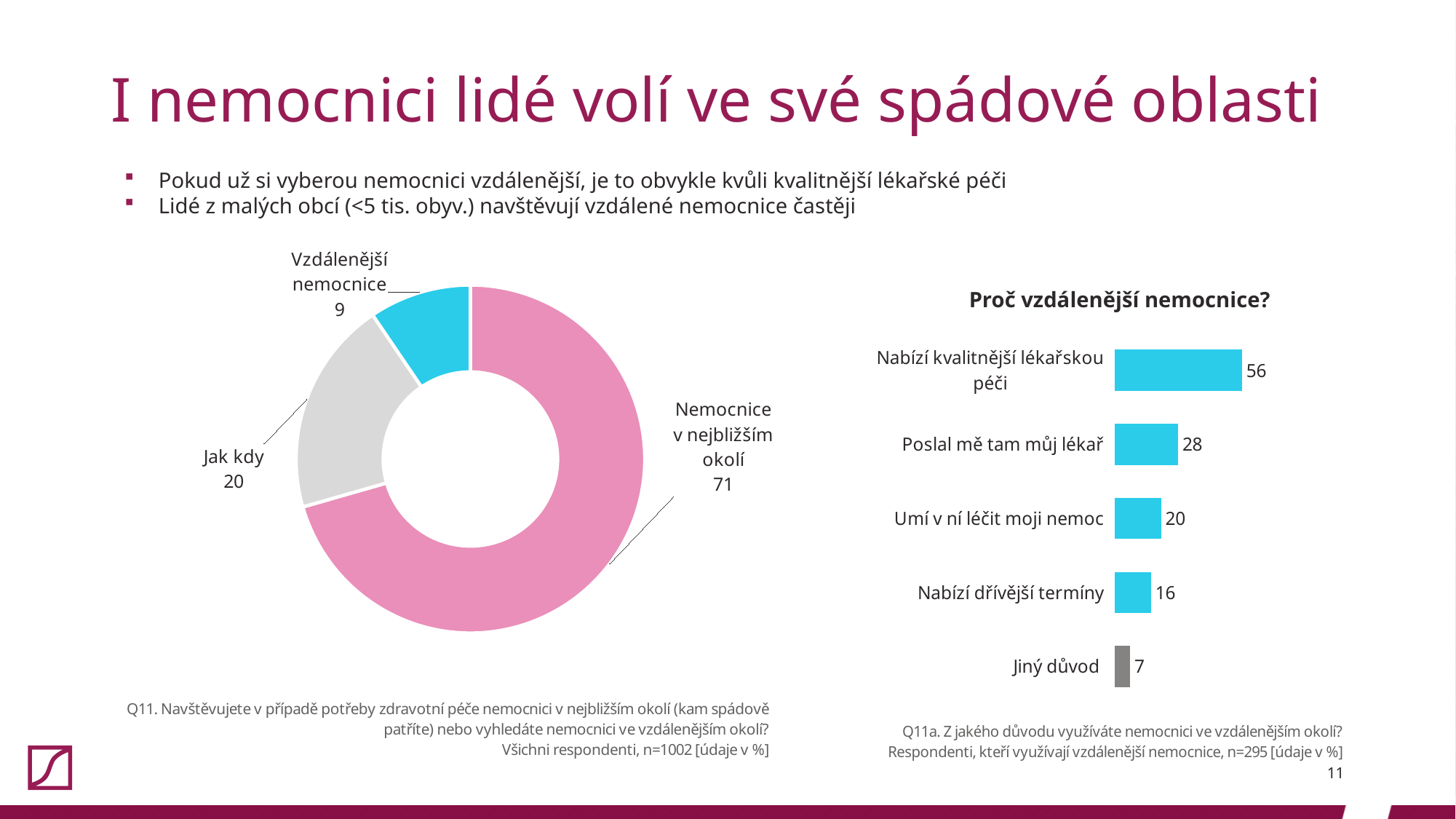
In the chart "Proč vzdálenější nemocnice?", which category has the lowest value? Jiný důvod In the chart "Proč vzdálenější nemocnice?", what is the difference between "Nabízí kvalitnější lékařskou péči" and "Nabízí dřívější termíny"? 40 In the donut chart on the left, what is the value for "Jak kdy"? 20 In the chart "Proč vzdálenější nemocnice?", what is the value for "Poslal mě tam můj lékař"? 28 In the chart "Proč vzdálenější nemocnice?", which category has the highest value? Nabízí kvalitnější lékařskou péči In the donut chart on the left, what is the difference between "Nemocnice v nejbližším okolí" and "Jak kdy"? 51 In the chart "Proč vzdálenější nemocnice?", how many categories are shown? 5 What kind of chart is the chart titled "Proč vzdálenější nemocnice?"? Bar chart In the donut chart on the left, how many categories are shown? 3 In the chart "Proč vzdálenější nemocnice?", which is larger: "Umí v ní léčit moji nemoc" or "Nabízí dřívější termíny"? Umí v ní léčit moji nemoc In the donut chart on the left, which category has the smallest value? Vzdálenější nemocnice In the donut chart on the left, what is the value for "Nemocnice v nejbližším okolí"? 71